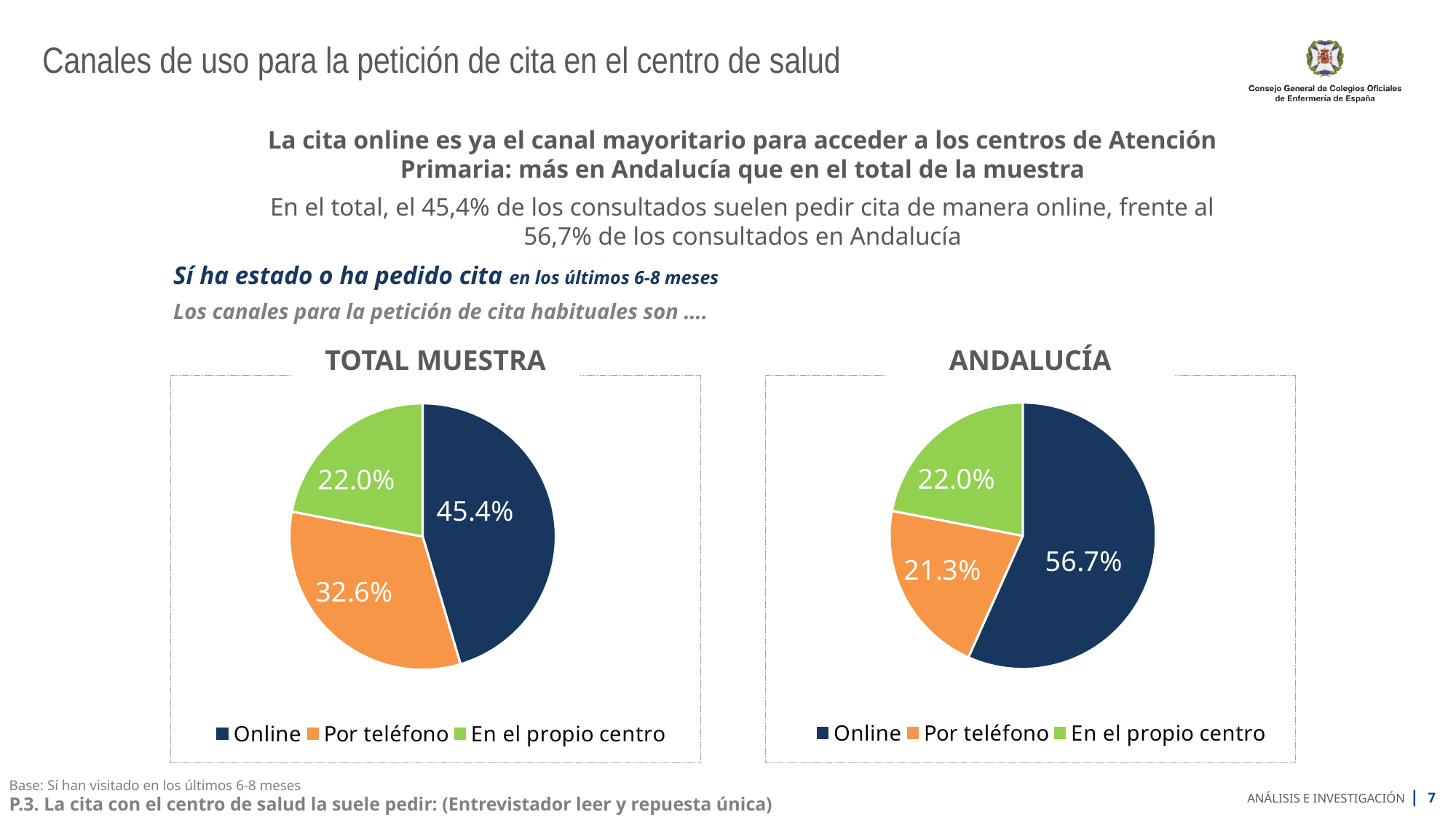
In the ANDALUCÍA chart, what colour is the Online slice? Dark blue In the TOTAL MUESTRA chart, what percentage is shown for En el propio centro? 22.0% How many entries does the legend of the TOTAL MUESTRA chart list? 3 In the ANDALUCÍA chart, which category has the largest share? Online In the ANDALUCÍA chart, what percentage is shown for Por teléfono? 21.3% In the TOTAL MUESTRA chart, what percentage is shown for Online? 45.4% What is the difference between the Online share in the ANDALUCÍA chart and the Online share in the TOTAL MUESTRA chart? 11.3% Which is larger: Por teléfono in the TOTAL MUESTRA chart or Por teléfono in the ANDALUCÍA chart? TOTAL MUESTRA In the TOTAL MUESTRA chart, which category has the smallest share? En el propio centro What type of chart is used for TOTAL MUESTRA? Pie chart In the TOTAL MUESTRA chart, what is the difference between the Online and Por teléfono shares? 12.8% How many slices does the ANDALUCÍA pie chart have? 3